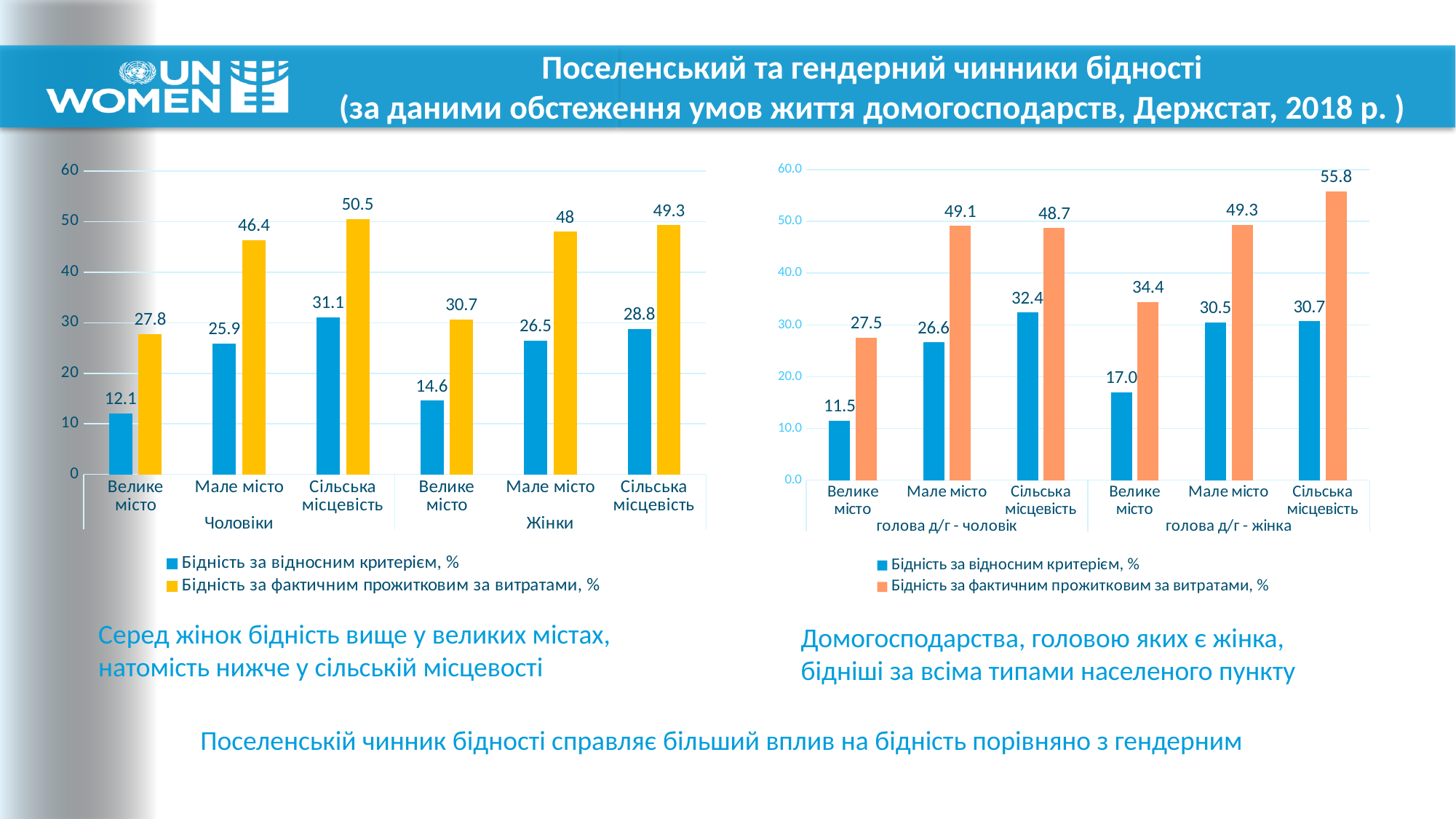
In the left chart, what is the value of 'Бідність за фактичним прожитковим за витратами, %' for 'Мале місто' in the 'Жінки' group? 48 In the left chart, how many categories are shown on the x axis? 6 In the right chart, what is the value of 'Бідність за фактичним прожитковим за витратами, %' for 'Сільська місцевість' in the 'голова д/г - жінка' group? 55.8 In the right chart, what colour are the bars for 'Бідність за фактичним прожитковим за витратами, %'? Orange In the left chart, which category has the highest value of 'Бідність за фактичним прожитковим за витратами, %'? Сільська місцевість (Чоловіки) In the right chart, what is the value of 'Бідність за відносним критерієм, %' for 'Велике місто' in the 'голова д/г - чоловік' group? 11.5 In the right chart, which is larger: 'Бідність за відносним критерієм, %' for 'Велике місто' in the 'голова д/г - жінка' group or in the 'голова д/г - чоловік' group? голова д/г - жінка In the left chart, what is the value of 'Бідність за відносним критерієм, %' for 'Велике місто' in the 'Чоловіки' group? 12.1 In the left chart, what is the difference between 'Бідність за фактичним прожитковим за витратами, %' and 'Бідність за відносним критерієм, %' for 'Велике місто' in the 'Чоловіки' group? 15.7 What kind of chart is the left chart? Bar chart How many series does the legend of the right chart list? 2 In the right chart, which category has the lowest value of 'Бідність за відносним критерієм, %'? Велике місто (голова д/г - чоловік)